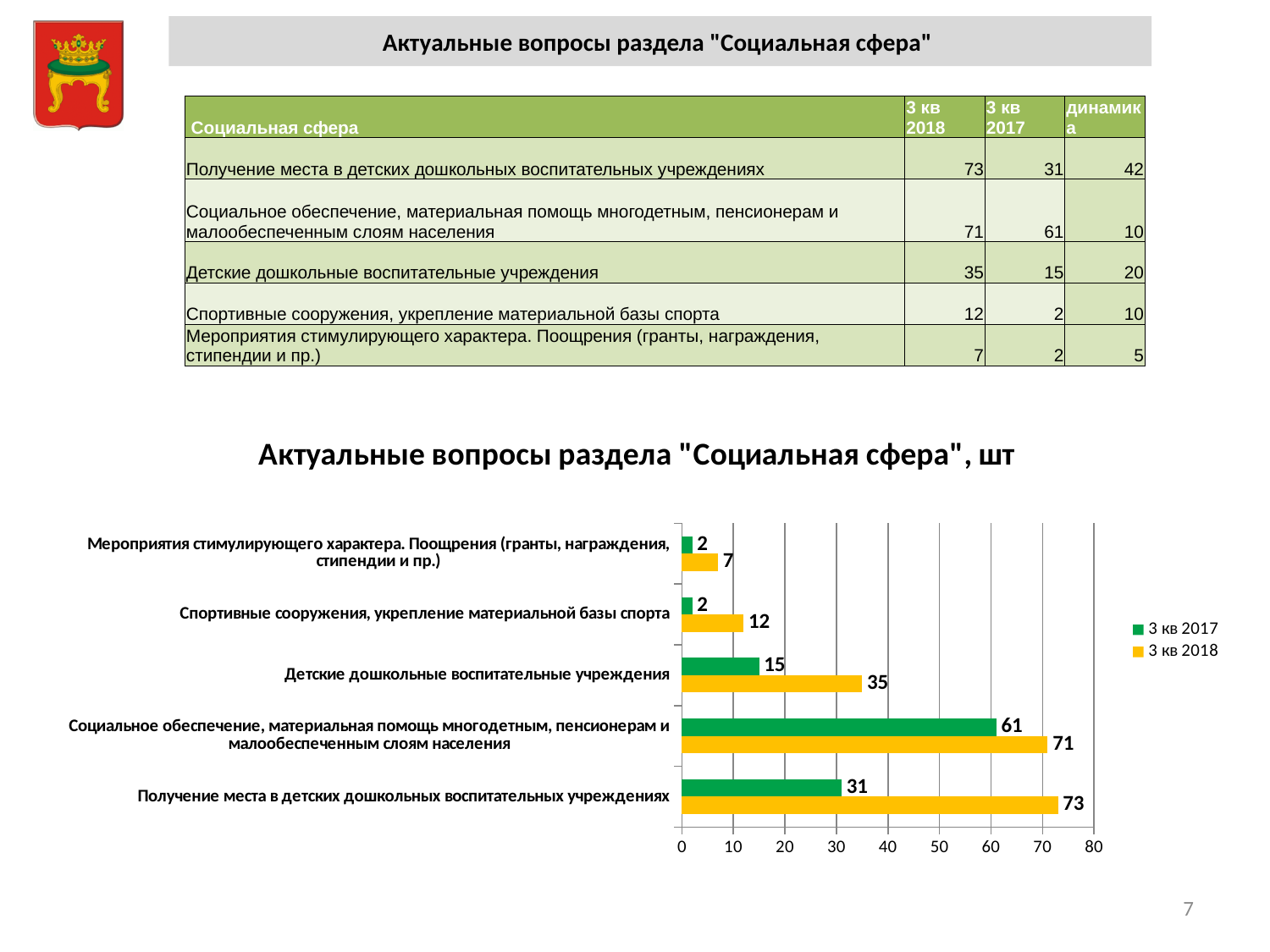
Is the 3 кв 2018 value for "Детские дошкольные воспитательные учреждения" greater or less than 30? greater What is the title of the chart? Актуальные вопросы раздела "Социальная сфера", шт Which category has the highest value in the 3 кв 2017 series? Социальное обеспечение, материальная помощь многодетным, пенсионерам и малообеспеченным слоям населения What is the value for "Спортивные сооружения, укрепление материальной базы спорта" in the 3 кв 2018 series? 12 How many series does the chart legend list? 2 How many categories are shown on the chart? 5 What is the difference between the 3 кв 2018 and 3 кв 2017 values for "Получение места в детских дошкольных воспитательных учреждениях"? 42 What is the value for "Детские дошкольные воспитательные учреждения" in the 3 кв 2017 series? 15 Which category has the lowest value in the 3 кв 2018 series? Мероприятия стимулирующего характера. Поощрения (гранты, награждения, стипендии и пр.) What is the value for "Получение места в детских дошкольных воспитательных учреждениях" in the 3 кв 2018 series? 73 What type of chart is shown on the slide? bar chart Which is larger for "Социальное обеспечение, материальная помощь многодетным, пенсионерам и малообеспеченным слоям населения": the 3 кв 2017 value or the 3 кв 2018 value? 3 кв 2018